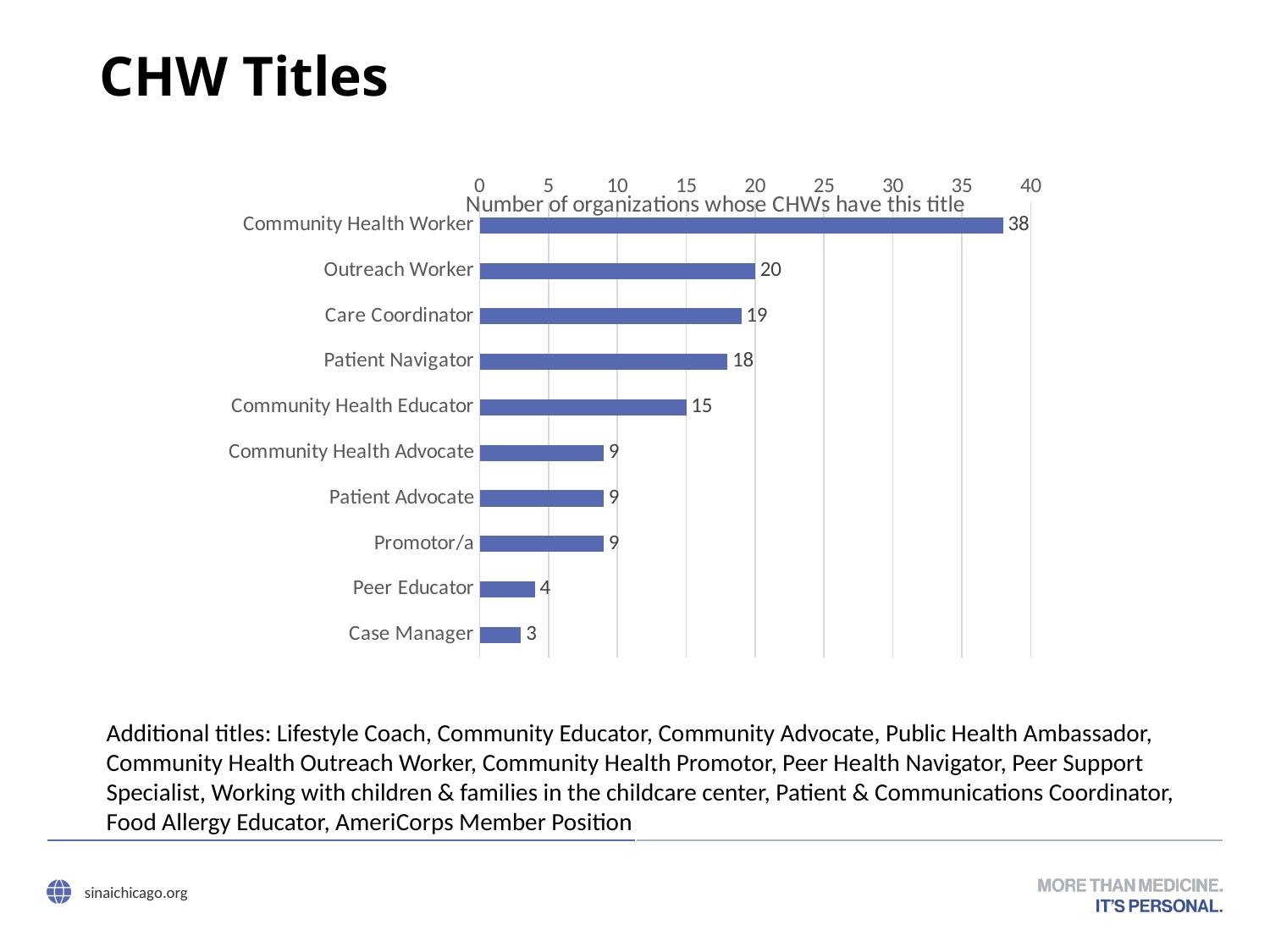
What is the difference between the values for Community Health Worker and Outreach Worker? 18 Which title has the highest number of organizations? Community Health Worker What is the value for Community Health Educator? 15 Which is larger, the value for Care Coordinator or the value for Community Health Educator? Care Coordinator What is the value for Patient Navigator? 18 Which title has the lowest number of organizations? Case Manager What is the difference between the values for Peer Educator and Case Manager? 1 What is the title of the chart? Number of organizations whose CHWs have this title Is the value for Outreach Worker greater or less than 15? greater How many titles are shown in the chart? 10 How many organizations have CHWs with the title Community Health Worker? 38 What kind of chart is shown on the slide? Bar chart